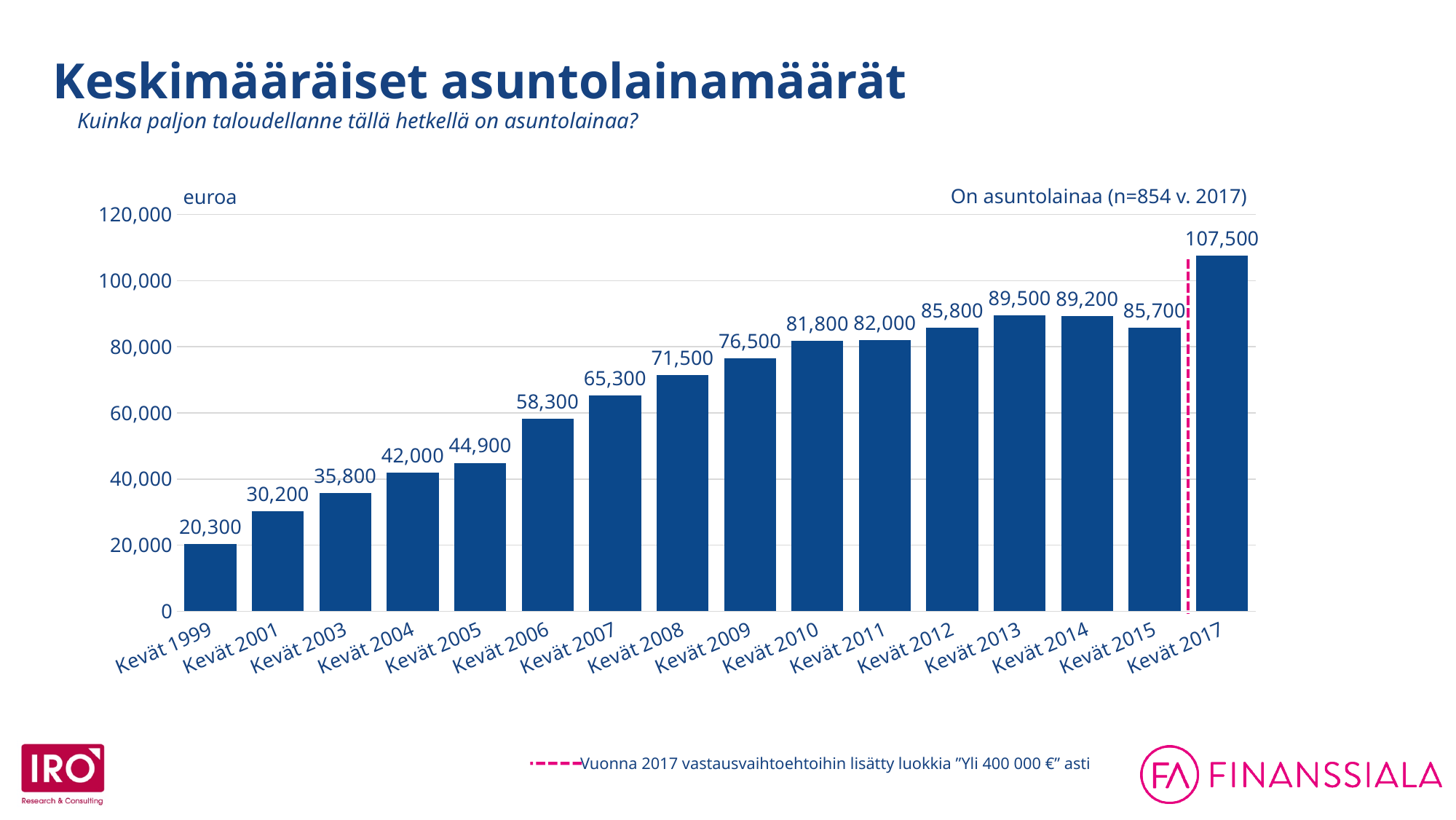
What is the title of the slide? Keskimääräiset asuntolainamäärät Which category has the lowest value? Kevät 1999 How many categories are shown on the x axis? 16 Which category has the highest value? Kevät 2017 What kind of chart is shown on the slide? bar chart What is the value for Kevät 1999? 20,300 What is the difference between the values for Kevät 2017 and Kevät 2015? 21,800 Which is larger, the value for Kevät 2013 or the value for Kevät 2014? Kevät 2013 Do the values generally rise or fall from Kevät 1999 to Kevät 2017? rise What is the value for Kevät 2008? 71,500 What is the value for Kevät 2017? 107,500 Is the value for Kevät 2006 greater or less than 60,000? less